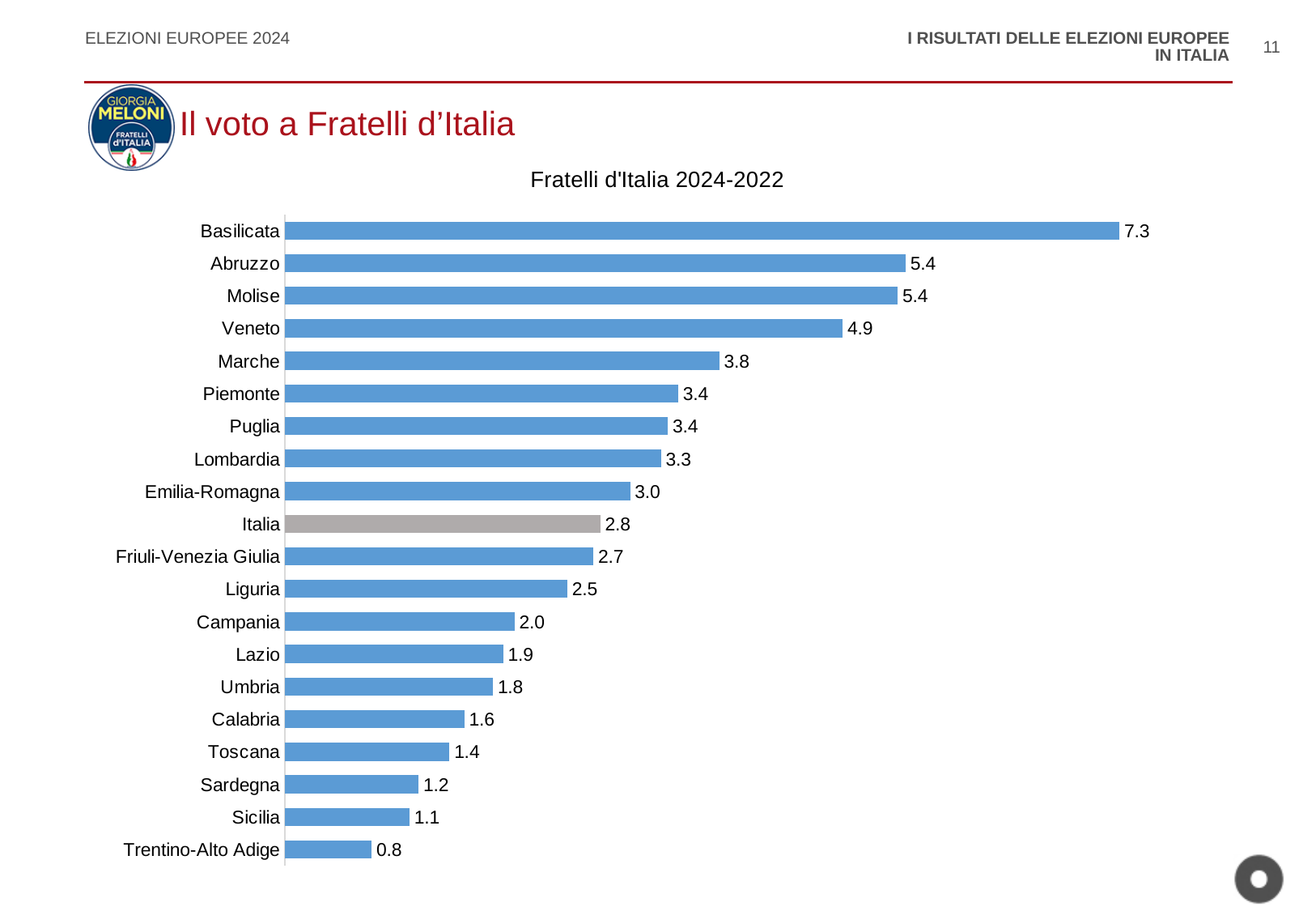
What is the value for Italia? 2.8 Which is larger, the value for Marche or the value for Lombardia? Marche What kind of chart is shown on the slide? Bar chart What is the difference between the values for Basilicata and Abruzzo? 1.9 Which category has the highest value? Basilicata What is the value for Basilicata? 7.3 Which category has the lowest value? Trentino-Alto Adige What is the value for Veneto? 4.9 What is the title of the chart? Fratelli d'Italia 2024-2022 How many categories are shown in the chart? 20 What is the value for Trentino-Alto Adige? 0.8 What is the difference between the values for Italia and Sicilia? 1.7